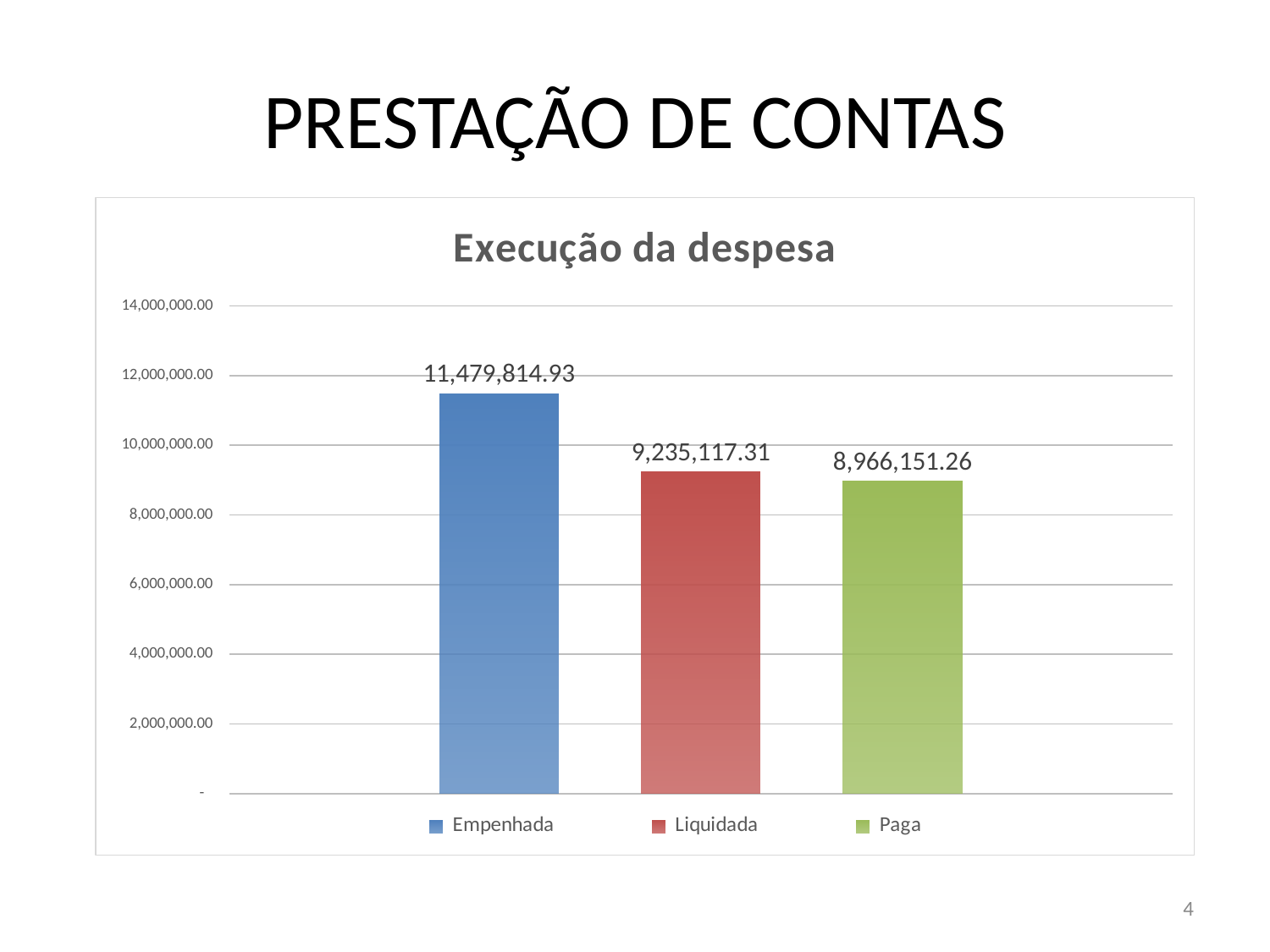
What is the value for Empenhada in the Execução da despesa chart? 11,479,814.93 What is the difference between the Liquidada and Paga values? 268,966.05 Is the value for Empenhada greater or less than 10,000,000.00? greater What is the value for Liquidada in the Execução da despesa chart? 9,235,117.31 How many bars are plotted in the Execução da despesa chart? 3 What is the difference between the Empenhada and Liquidada values? 2,244,697.62 Which category has the lowest value in the Execução da despesa chart? Paga What is the value for Paga in the Execução da despesa chart? 8,966,151.26 Do the values rise or fall from left to right across the bars? Fall Which is larger, the value for Empenhada or the value for Paga? Empenhada What kind of chart is shown on the slide? Bar chart Which category has the highest value in the Execução da despesa chart? Empenhada